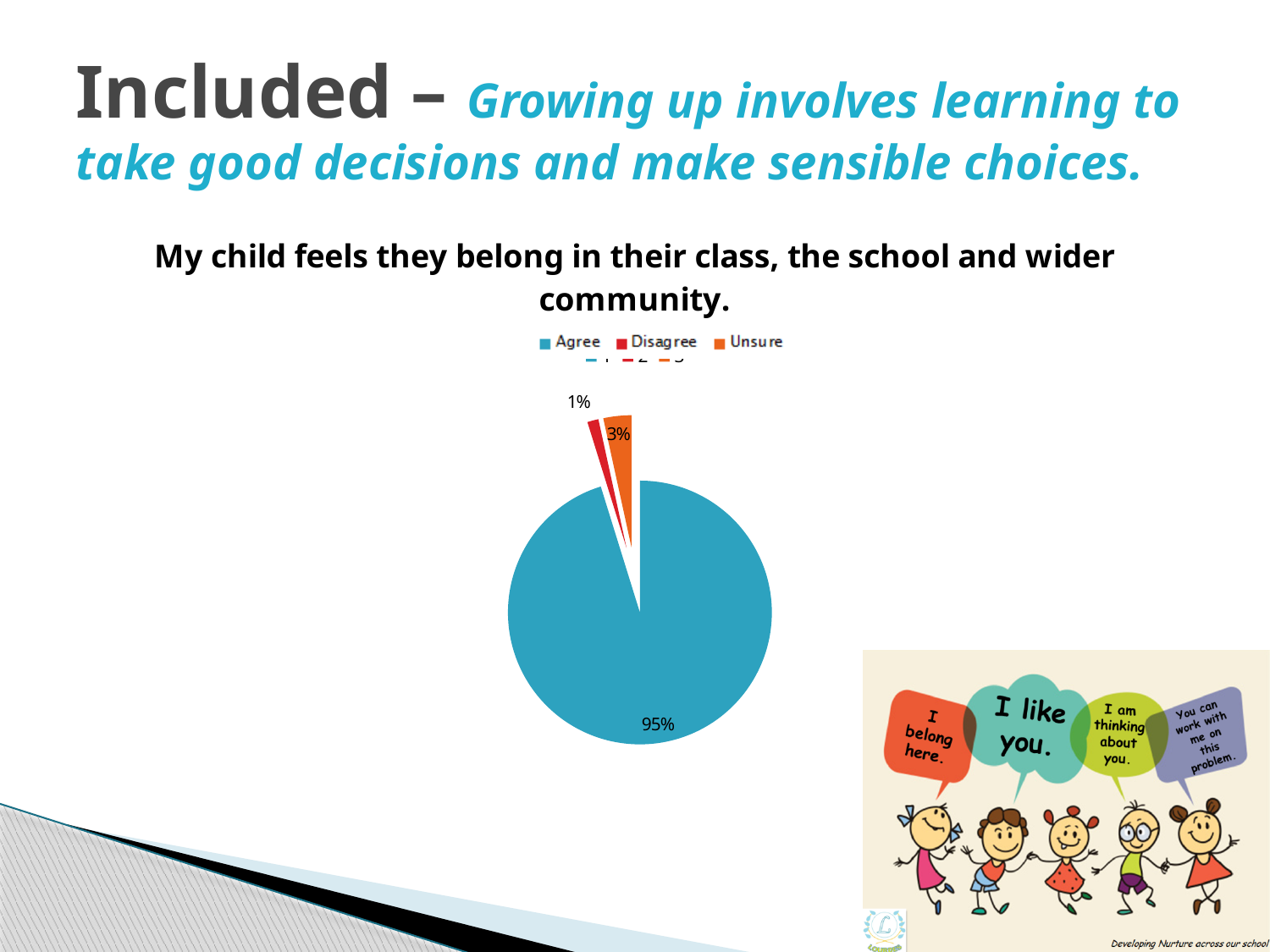
Which response has the largest share of the pie? Agree What percentage of respondents chose Unsure? 3% What statement does the pie chart report responses to? My child feels they belong in their class, the school and wider community. What is the difference in percentage points between Agree and Unsure? 92 Which response has the smallest share of the pie? Disagree How many slices does the pie chart have? 3 What kind of chart is shown on the slide? pie chart Which is larger, the share for Unsure or the share for Disagree? Unsure What percentage of respondents chose Disagree? 1% What colour is the Agree slice? blue How many entries does the legend list? 3 What percentage of respondents chose Agree? 95%